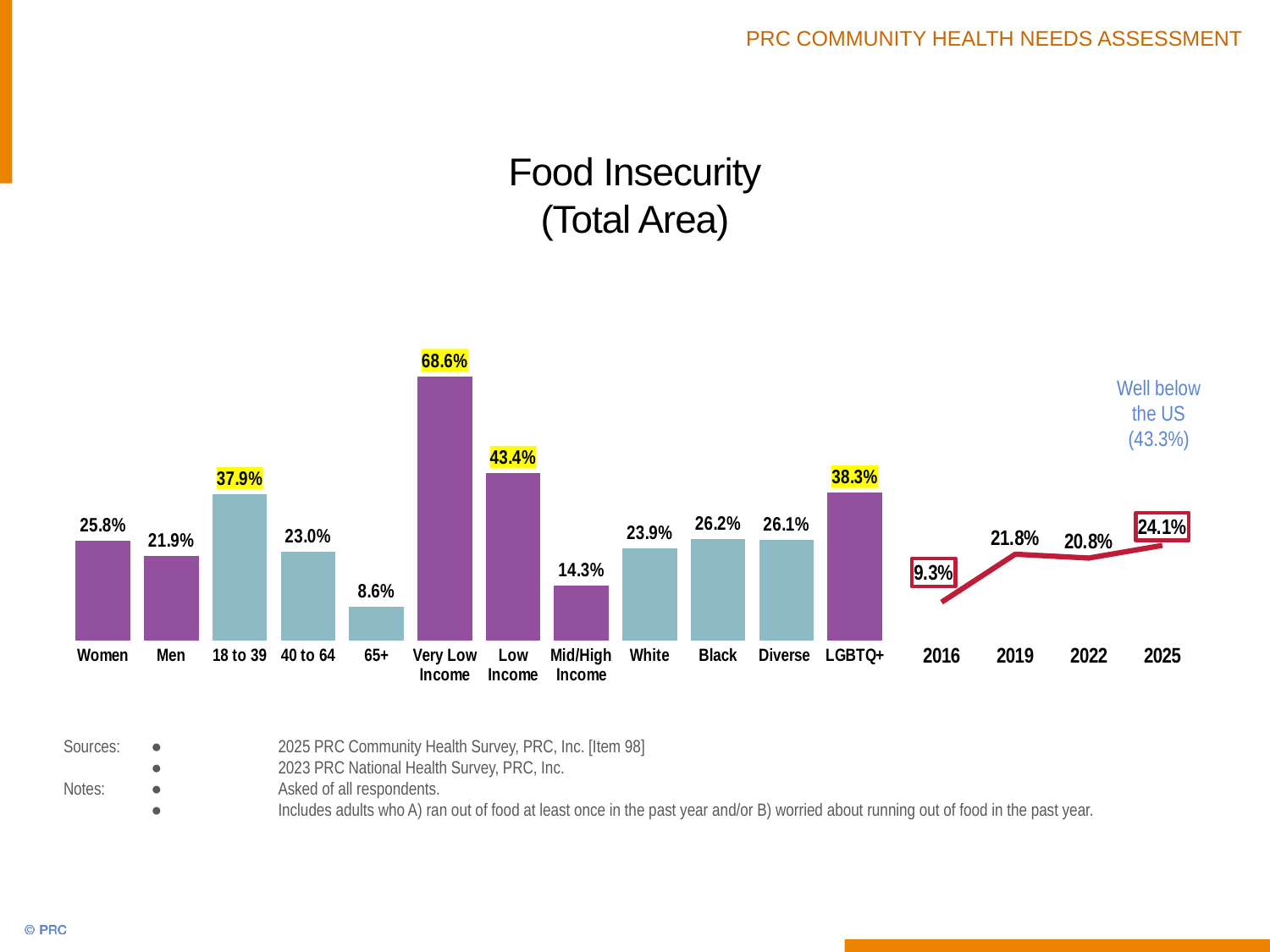
In the bar chart, which category has the lowest value? 65+ In the line chart, what is the difference between the 2025 and 2022 values? 3.3% In the bar chart, which category has the highest value? Very Low Income In the bar chart, what is the difference between the Women and Men values? 3.9% How many categories are shown in the bar chart? 12 What kind of chart shows the 2016 to 2025 values? Line chart In the line chart, what is the value for 2016? 9.3% In the bar chart, what is the value for Women? 25.8% In the line chart, what is the value for 2025? 24.1% In the bar chart, what is the value for LGBTQ+? 38.3% In the bar chart, which is larger, the value for 18 to 39 or the value for 40 to 64? 18 to 39 In the bar chart, what is the food insecurity value for Very Low Income? 68.6%